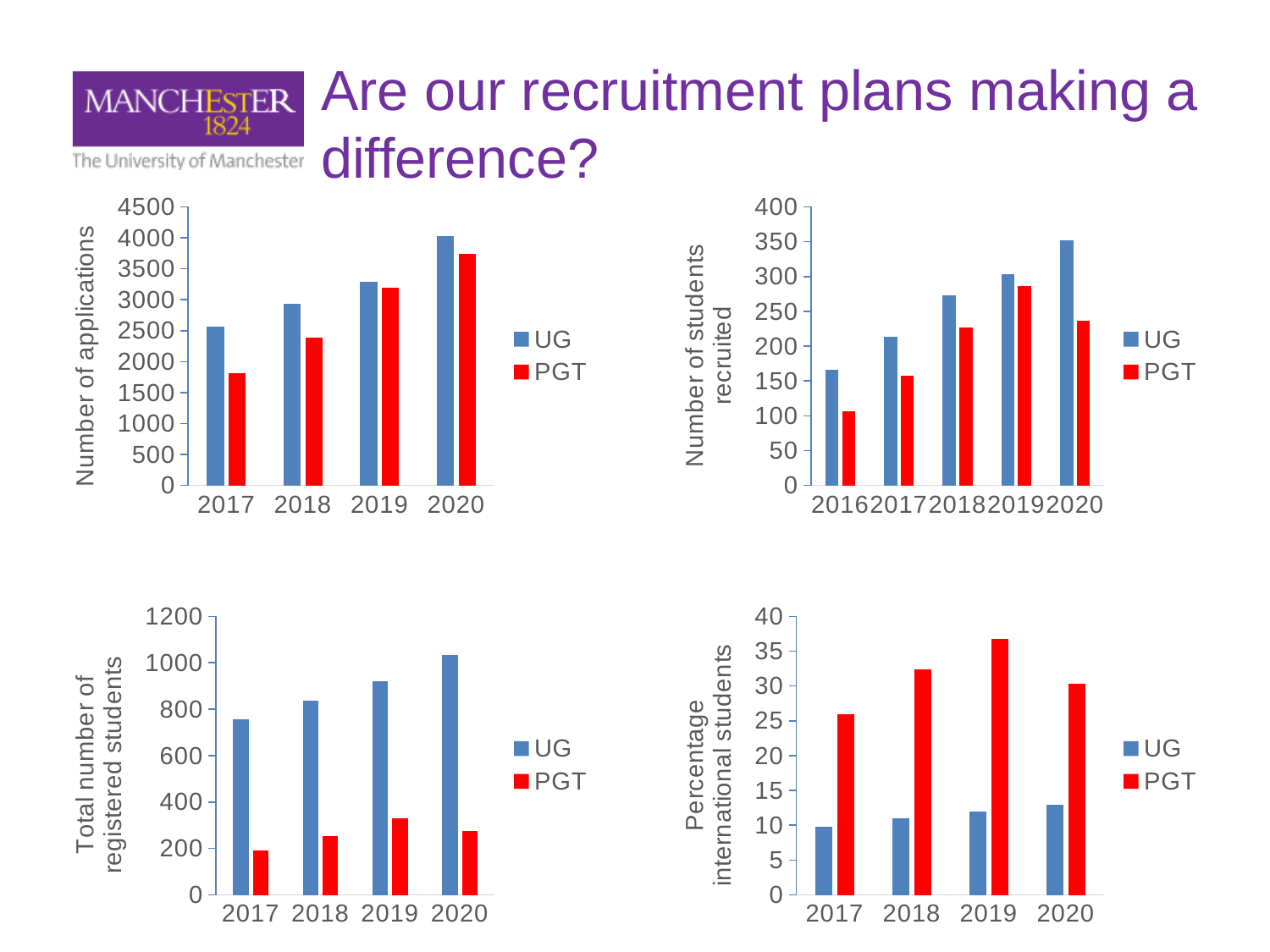
What are the two legend entries in the bottom-right chart (Percentage international students)? UG and PGT In the bottom-right chart (Percentage international students), which year has the highest PGT value? 2019 In the top-left chart (Number of applications), is the PGT value for 2017 greater or less than 2000? less In the top-right chart (Number of students recruited), how many years are shown on the x axis? 5 How many series does the legend of the top-left chart (Number of applications) list? 2 In the top-left chart (Number of applications), which year has the highest UG value? 2020 In the bottom-left chart (Total number of registered students), which is larger in 2020, UG or PGT? UG In the bottom-left chart (Total number of registered students), do the UG values rise or fall from 2017 to 2020? rise In the top-left chart (Number of applications), how many years are shown on the x axis? 4 In the top-right chart (Number of students recruited), which year has the highest PGT value? 2019 In the top-right chart (Number of students recruited), is the UG value for 2020 greater or less than 300? greater What kind of chart is the top-left chart (Number of applications)? bar chart